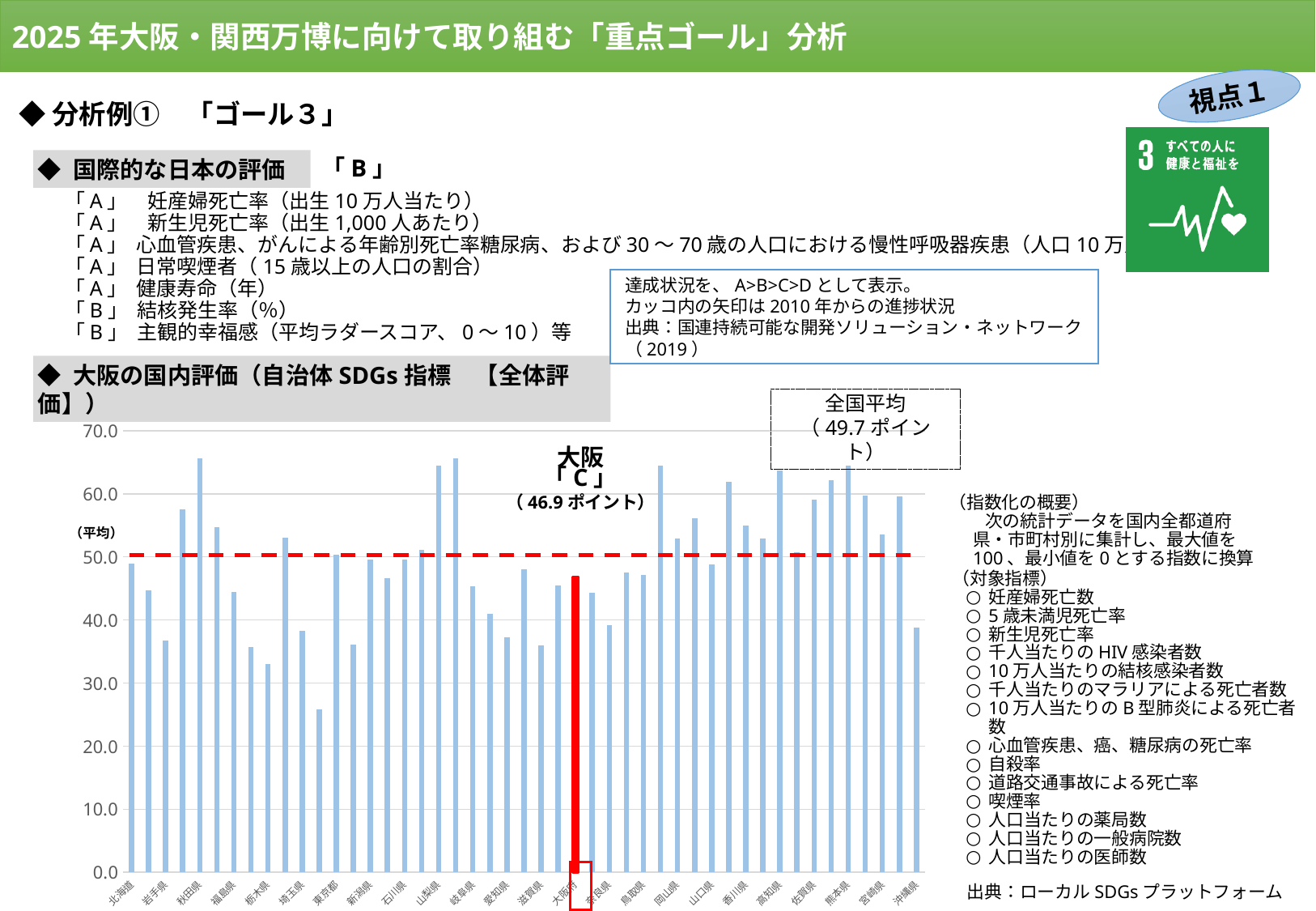
What does the red dashed horizontal line in the chart represent? 全国平均 (49.7 ポイント) Is the value for 栃木県 greater or less than 40.0? less What is the 全国平均 (national average) value shown on the chart? 49.7 ポイント What is the difference between the national average (49.7 ポイント) and Osaka's value (46.9 ポイント)? 2.8 ポイント How many bars (prefectures) are plotted in the chart? 47 Is the value for 東京都 greater or less than 30.0? greater What colour is the bar for 大阪府 in the chart? red What is the value shown for 大阪 (Osaka) in the chart? 46.9 ポイント Is the value for 秋田県 greater or less than 60.0? greater Which is larger, Osaka's value or the national average? the national average What kind of chart is shown on the slide? bar chart